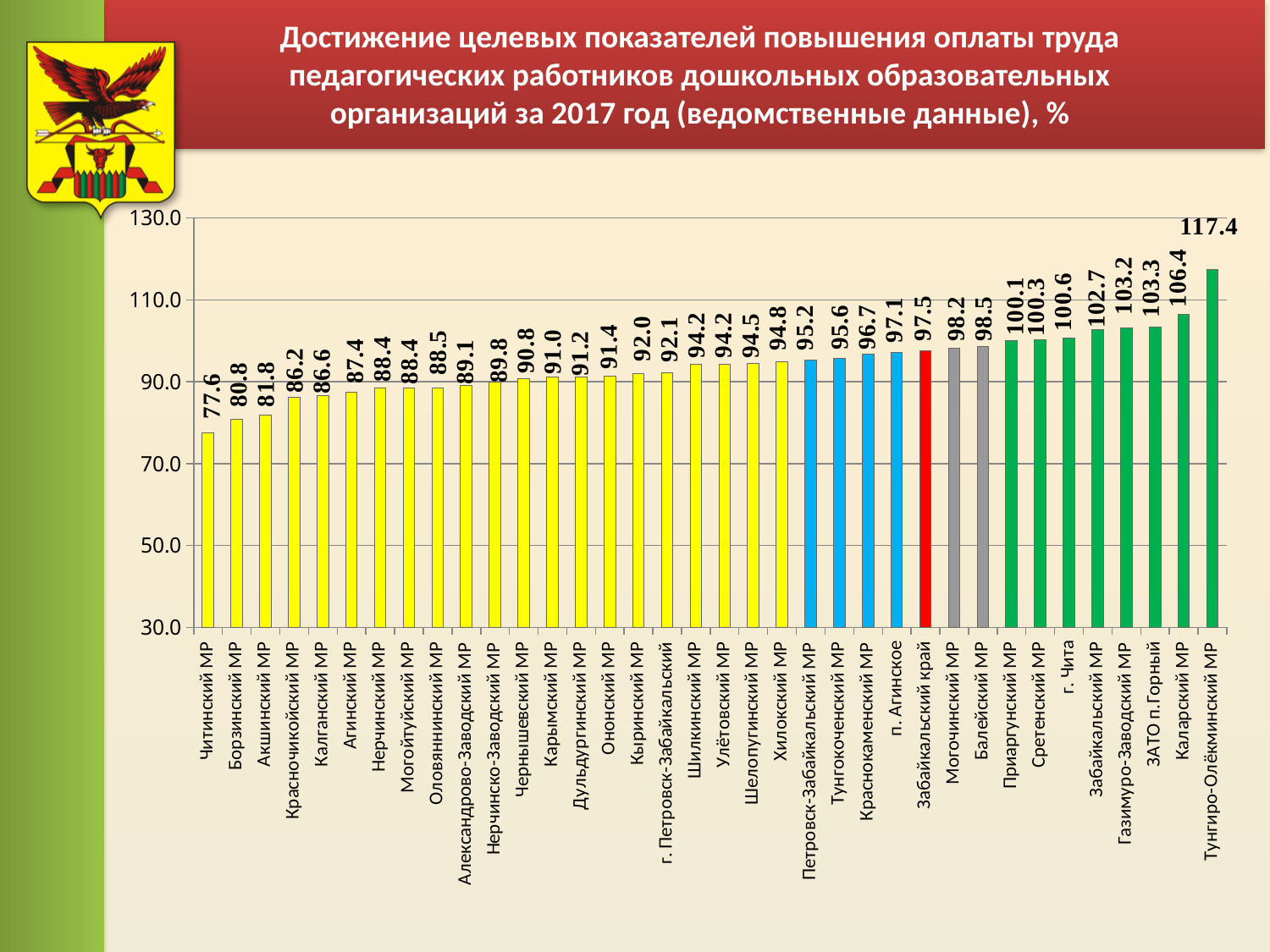
Which is larger, the value for Краснокаменский МР or the value for Балейский МР? Балейский МР What is the value for Каларский МР? 106.4 Is the value for Борзинский МР greater or less than 90.0? less Which category has the lowest value? Читинский МР What is the difference between the values for Тунгиро-Олёкминский МР and Читинский МР? 39.8 Which category has the highest value? Тунгиро-Олёкминский МР What is the value for Забайкальский край? 97.5 What kind of chart is shown on the slide? bar chart How many categories are shown on the x axis? 36 What is the value for Читинский МР? 77.6 What is the value for г. Чита? 100.6 Do the values rise or fall from left to right along the x axis? rise